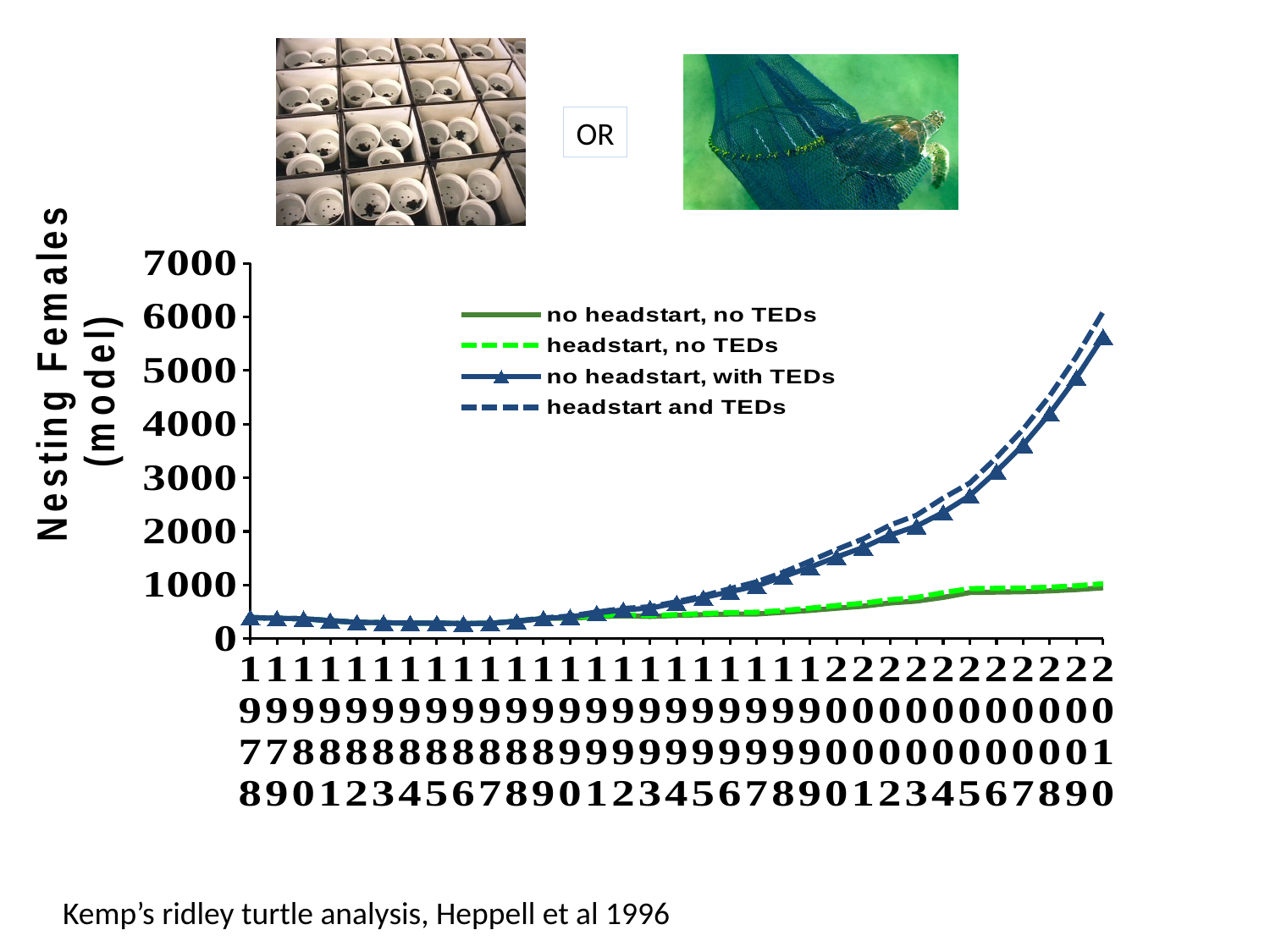
How many years are plotted along the x axis of the chart? 33 What is the first year shown on the x axis of the chart? 1978 How many series does the chart legend list? 4 What kind of chart is shown on the slide? line chart What is the label on the y axis of the chart? Nesting Females (model) Is the value for 'headstart and TEDs' in 2010 greater or less than 5000? greater Which series reaches the highest value in 2010? headstart and TEDs Which series is drawn with triangle markers in the chart? no headstart, with TEDs What is the last year shown on the x axis of the chart? 2010 Does the 'no headstart, with TEDs' series rise or fall from 1990 to 2010? rise Is the value for 'no headstart, no TEDs' in 2010 greater or less than 2000? less In 2010, which is larger: 'no headstart, with TEDs' or 'headstart, no TEDs'? no headstart, with TEDs